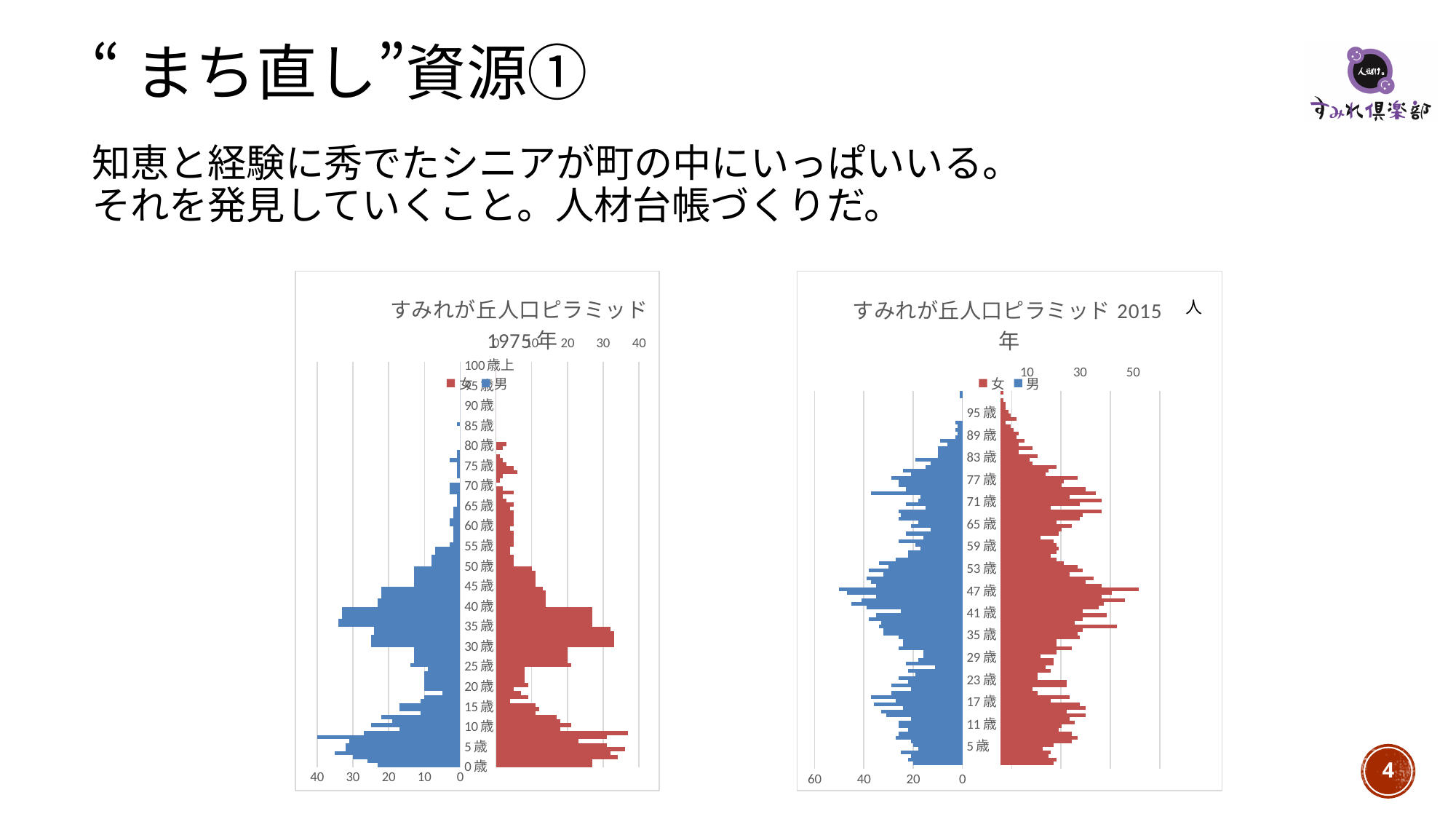
How many series does the legend of the left chart (1975年) list? 2 In the left chart (1975年), which series is shown in blue? 男 What kind of chart is the left chart titled すみれが丘人口ピラミッド 1975年? bar chart In the right chart (2015年), which series is shown in red? 女 In the left chart (1975年), is the value for 女 at 30歳 greater or less than 20? greater In the right chart (2015年), is the value for 男 at 95歳 greater or less than 20? less What kind of chart is the right chart titled すみれが丘人口ピラミッド 2015年? bar chart In the left chart (1975年), is the value for 男 at 35歳 greater or less than 20? greater How many series does the legend of the right chart (2015年) list? 2